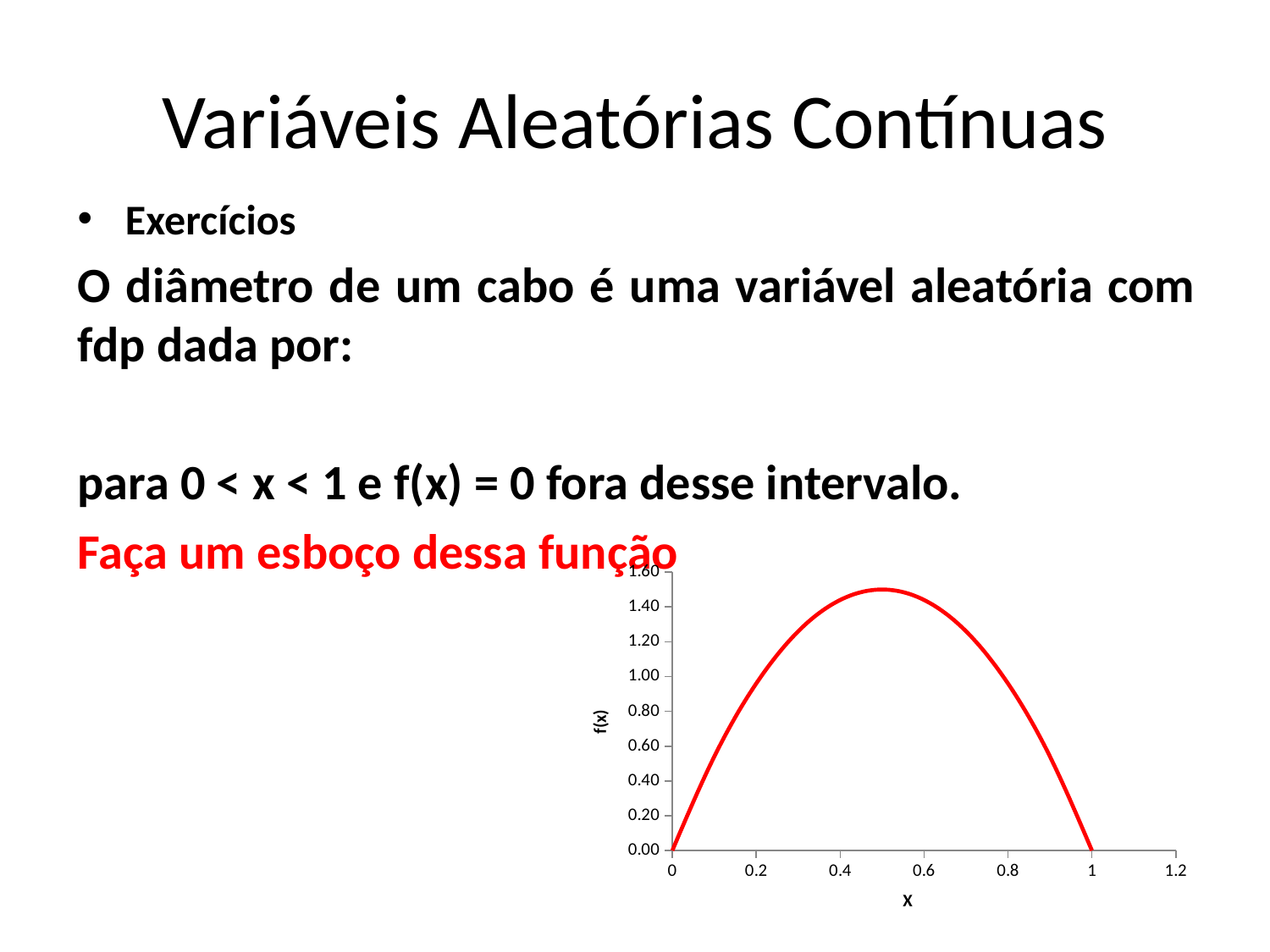
What is the label of the vertical axis of the chart? f(x) What is the value of f(x) at x = 1 on the chart? 0.00 Is the value of f(x) at x = 0.4 greater or less than 1.20? greater What is the highest tick value shown on the vertical axis of the chart? 1.60 How does f(x) behave as x increases from 0 to 1 on the chart? rises then falls Is the peak value of f(x) on the chart greater or less than 1.60? less Is the peak value of f(x) on the chart greater or less than 1.40? greater What is the value of f(x) at x = 0 on the chart? 0.00 What is the label of the horizontal axis of the chart? x What kind of chart is shown on the slide? line chart Which is larger on the chart: f(x) at x = 0.4 or f(x) at x = 0.2? x = 0.4